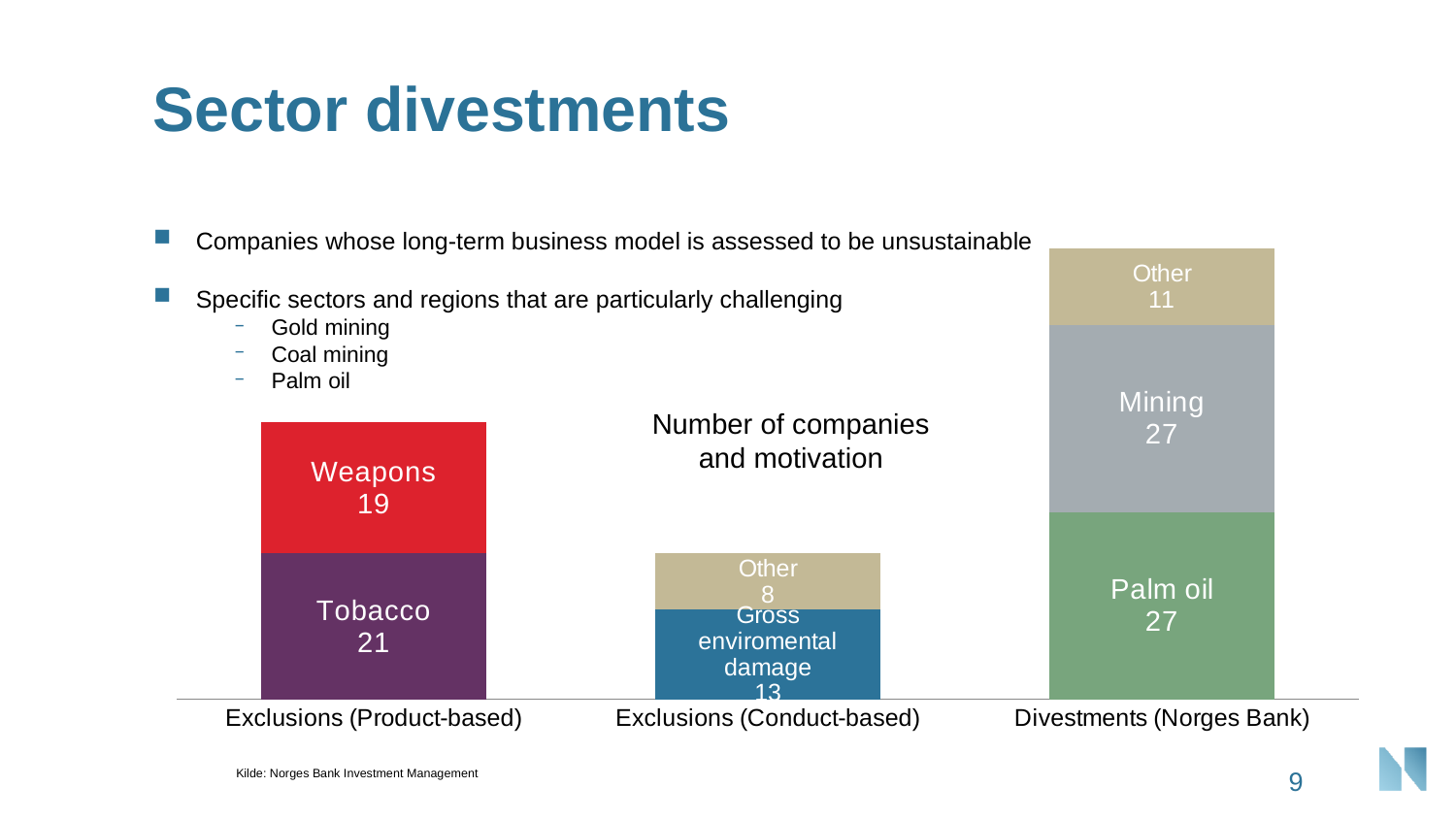
What is the value for Gross environmental damage in the Exclusions (Conduct-based) bar? 13 What is the total of the Exclusions (Product-based) stacked bar? 40 How many categories are shown along the x axis of the chart? 3 What kind of chart is shown on the slide? Stacked bar chart What is the value for Weapons in the Exclusions (Product-based) bar? 19 What is the difference between the Palm oil value and the Other value in the Divestments (Norges Bank) bar? 16 How many companies are shown for Tobacco in the Exclusions (Product-based) bar? 21 What is the value for Mining in the Divestments (Norges Bank) bar? 27 What is the total of the Divestments (Norges Bank) stacked bar? 65 What is the title of the chart? Number of companies and motivation Which category has the highest total number of companies? Divestments (Norges Bank) What is the total of the Exclusions (Conduct-based) stacked bar? 21